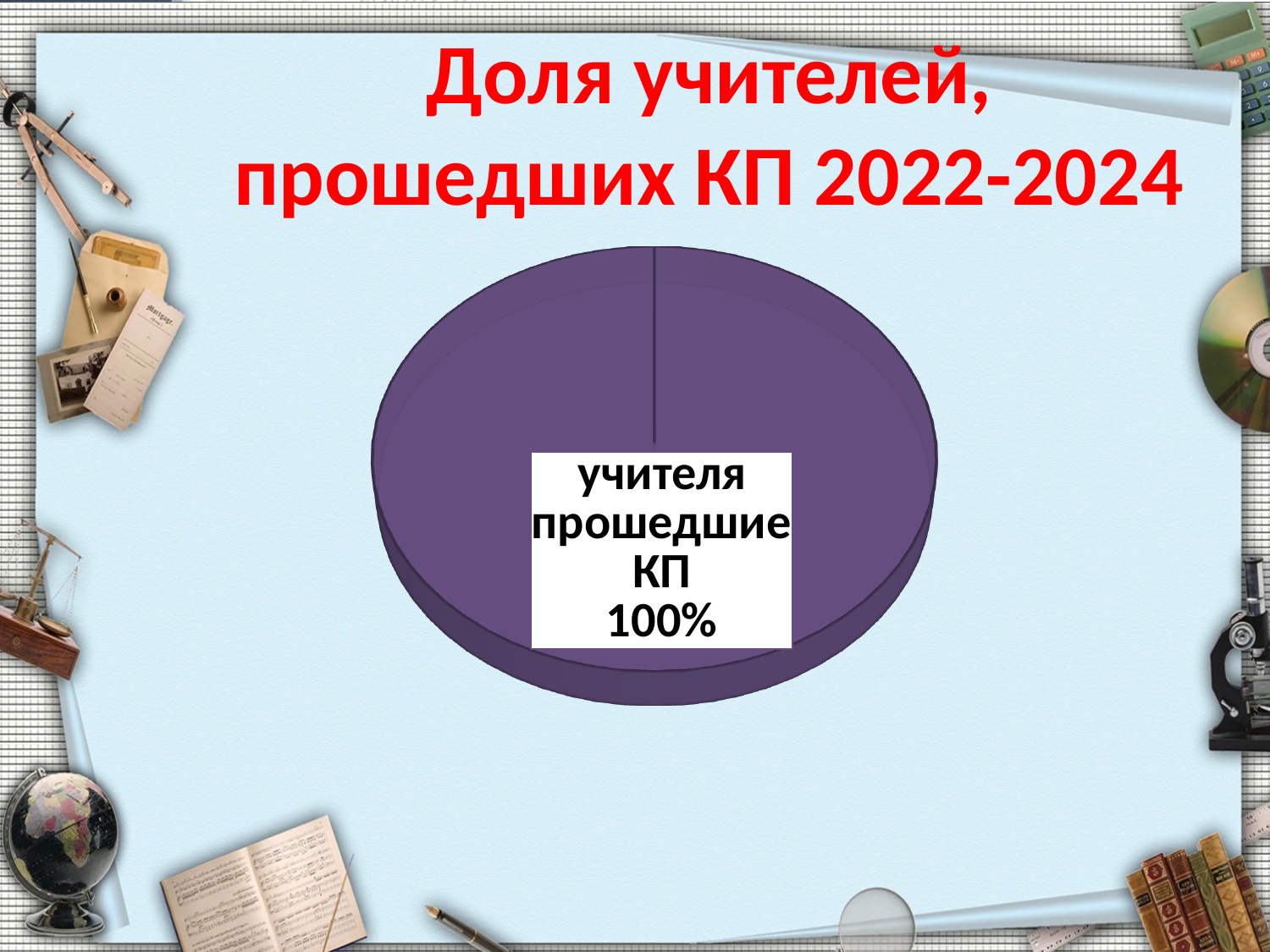
How many slices does the pie chart have? 1 What colour is the pie slice? purple What is the title of the chart on the slide? Доля учителей, прошедших КП 2022-2024 What value is printed on the data label of the pie chart? учителя прошедшие КП 100% What share of the pie does the slice "учителя прошедшие КП" take? 100% Is the value for "учителя прошедшие КП" greater or less than 50%? greater What category label is shown on the pie chart? учителя прошедшие КП What kind of chart is shown on the slide? pie chart